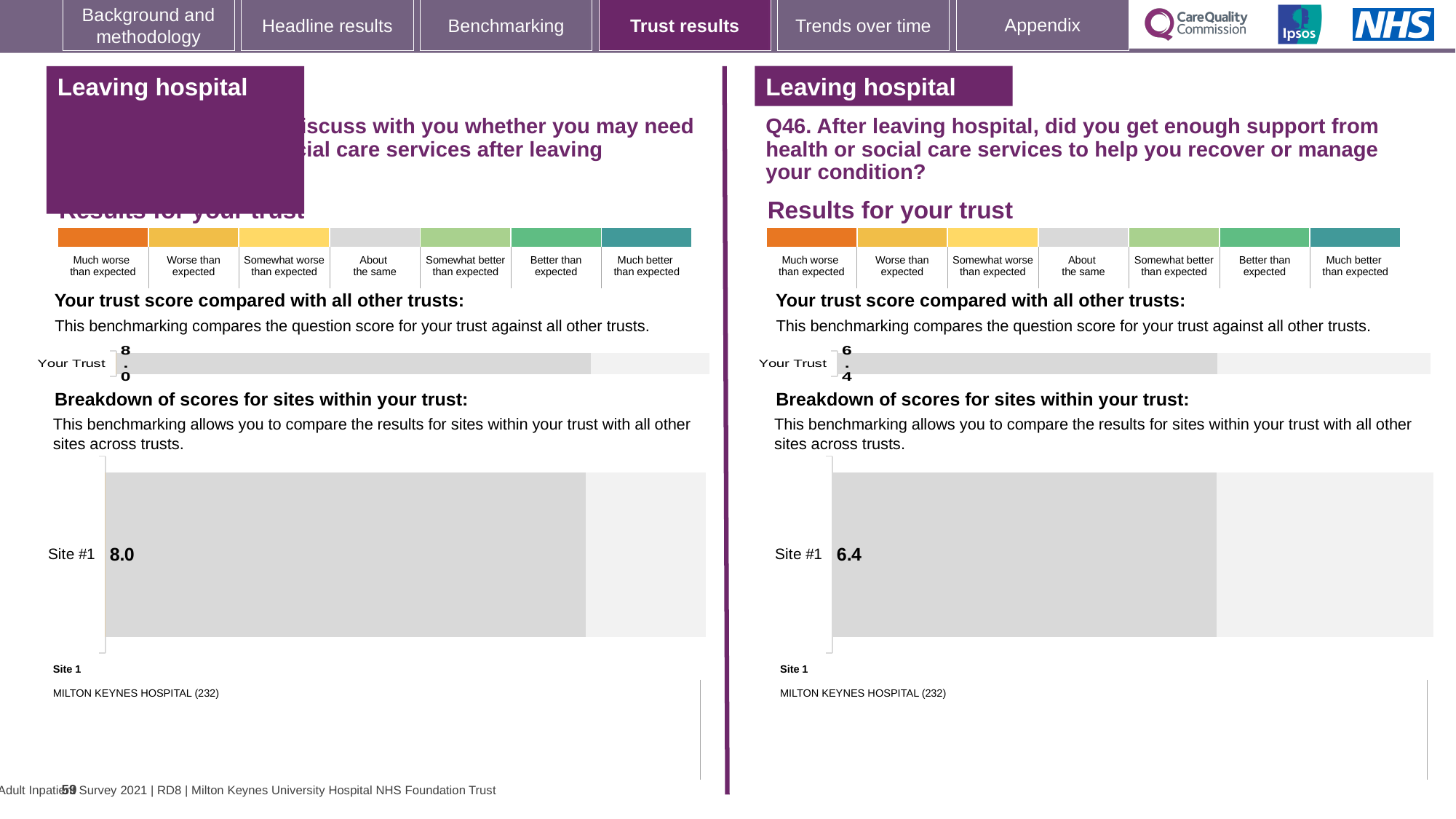
What is the difference between the Site #1 score on the left-hand side of the slide and the Site #1 score on the right-hand side (Q46)? 1.6 On the right-hand side of the slide (Q46), which site name is listed as Site 1? MILTON KEYNES HOSPITAL (232) On the left-hand side of the slide, what is the score shown for Your Trust? 8.0 On the right-hand side of the slide (Q46), what is the score shown for Site #1? 6.4 On the left-hand side of the slide, is the Site #1 score the same as the Your Trust score? Yes, both are 8.0 On the left-hand side of the slide, what is the score shown for Site #1? 8.0 Which is larger: the Your Trust score on the left-hand side of the slide or the Your Trust score on the right-hand side (Q46)? Left-hand side (8.0) How many sites are shown in the 'Breakdown of scores for sites within your trust' chart on the right-hand side of the slide (Q46)? 1 How many categories are shown in the colour scale legend above the 'Your trust score compared with all other trusts' chart on the right-hand side of the slide? 7 On the right-hand side of the slide (Q46), what is the score shown for Your Trust? 6.4 What kind of chart is used to show the Site #1 score on the right-hand side of the slide (Q46)? Bar chart